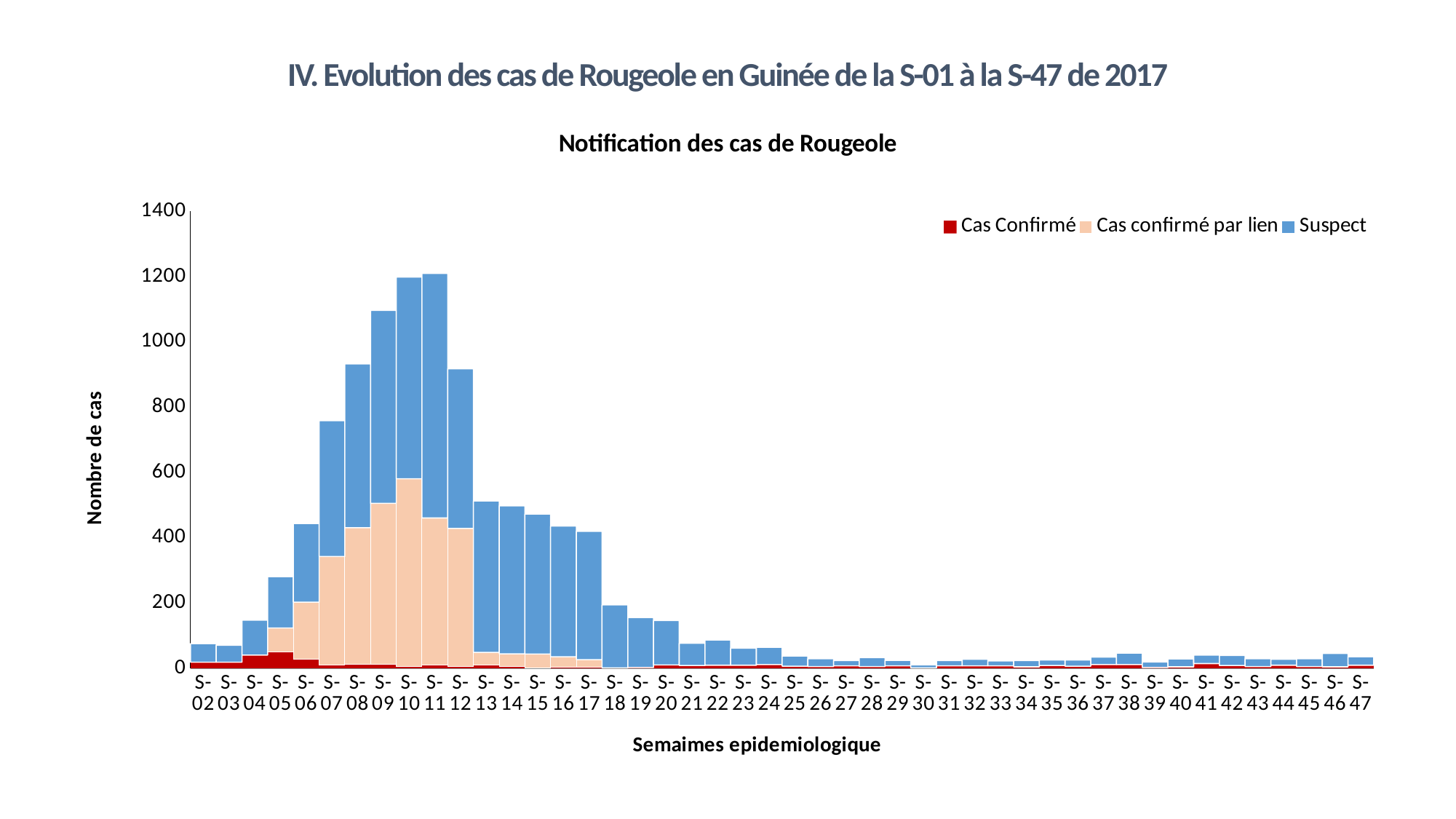
Is the total value for S-12 greater or less than 1000? less Which week has the larger total, S-07 or S-13? S-07 What is the label of the y axis? Nombre de cas How many series does the legend list? 3 Is the total value for S-09 greater or less than 1000? greater What kind of chart is shown on the slide? bar chart How many epidemiological weeks are shown on the x axis? 46 Is the total value for S-13 greater or less than 400? greater Which week has the larger total, S-09 or S-12? S-09 Do the total values rise or fall from S-11 to S-20? fall